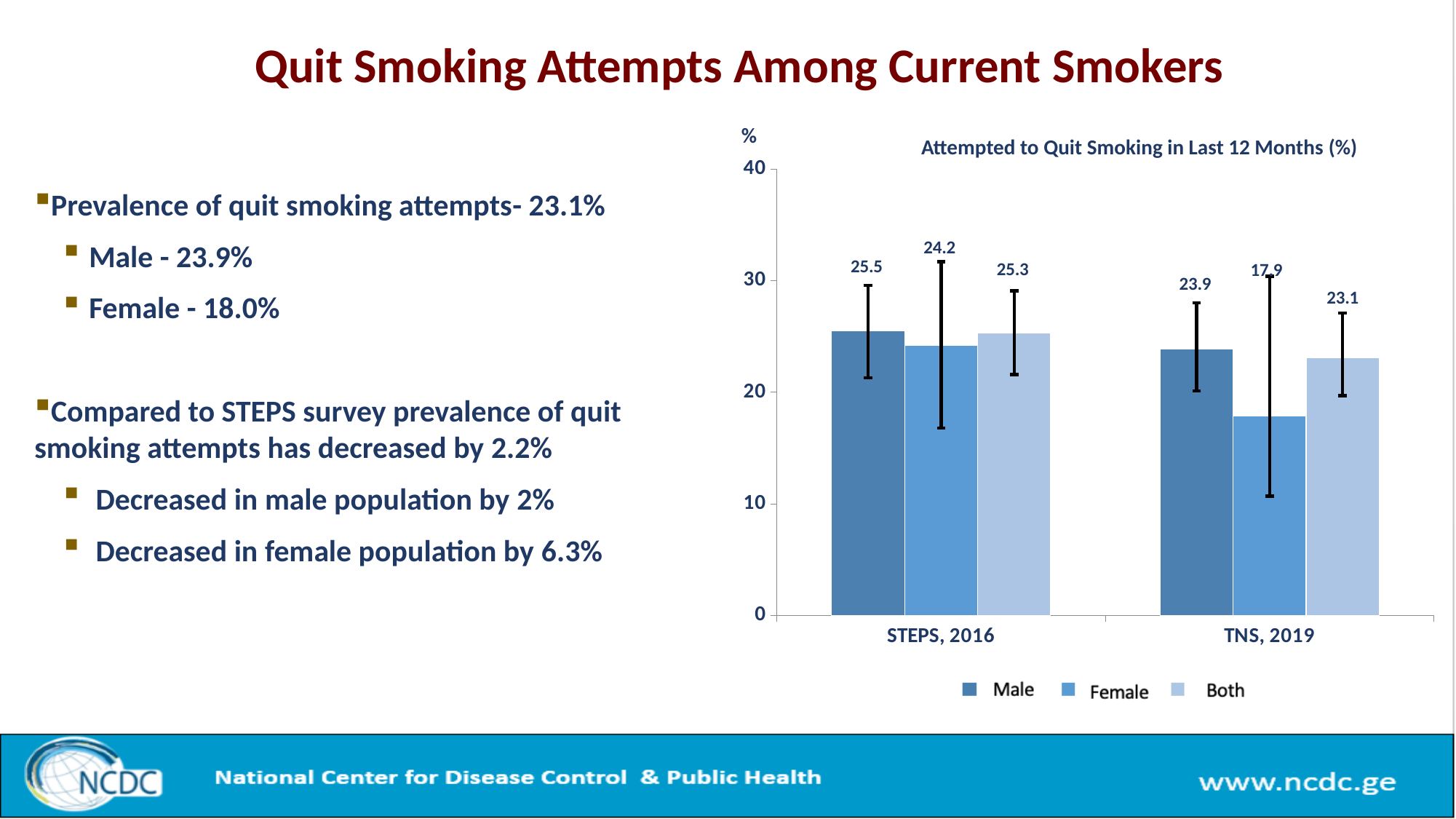
How many series does the legend list? 3 How many categories are shown on the x axis? 2 What is the Male value for STEPS, 2016? 25.5 What kind of chart is shown on the slide? Bar chart Which is larger, the Female value for STEPS, 2016 or the Female value for TNS, 2019? STEPS, 2016 What is the difference between the Female values for STEPS, 2016 and TNS, 2019? 6.3 Which series has the lowest value for TNS, 2019? Female What is the title of the chart? Attempted to Quit Smoking in Last 12 Months (%) What is the Both value for STEPS, 2016? 25.3 What is the Female value for TNS, 2019? 17.9 What is the Both value for TNS, 2019? 23.1 What is the difference between the Male values for STEPS, 2016 and TNS, 2019? 1.6